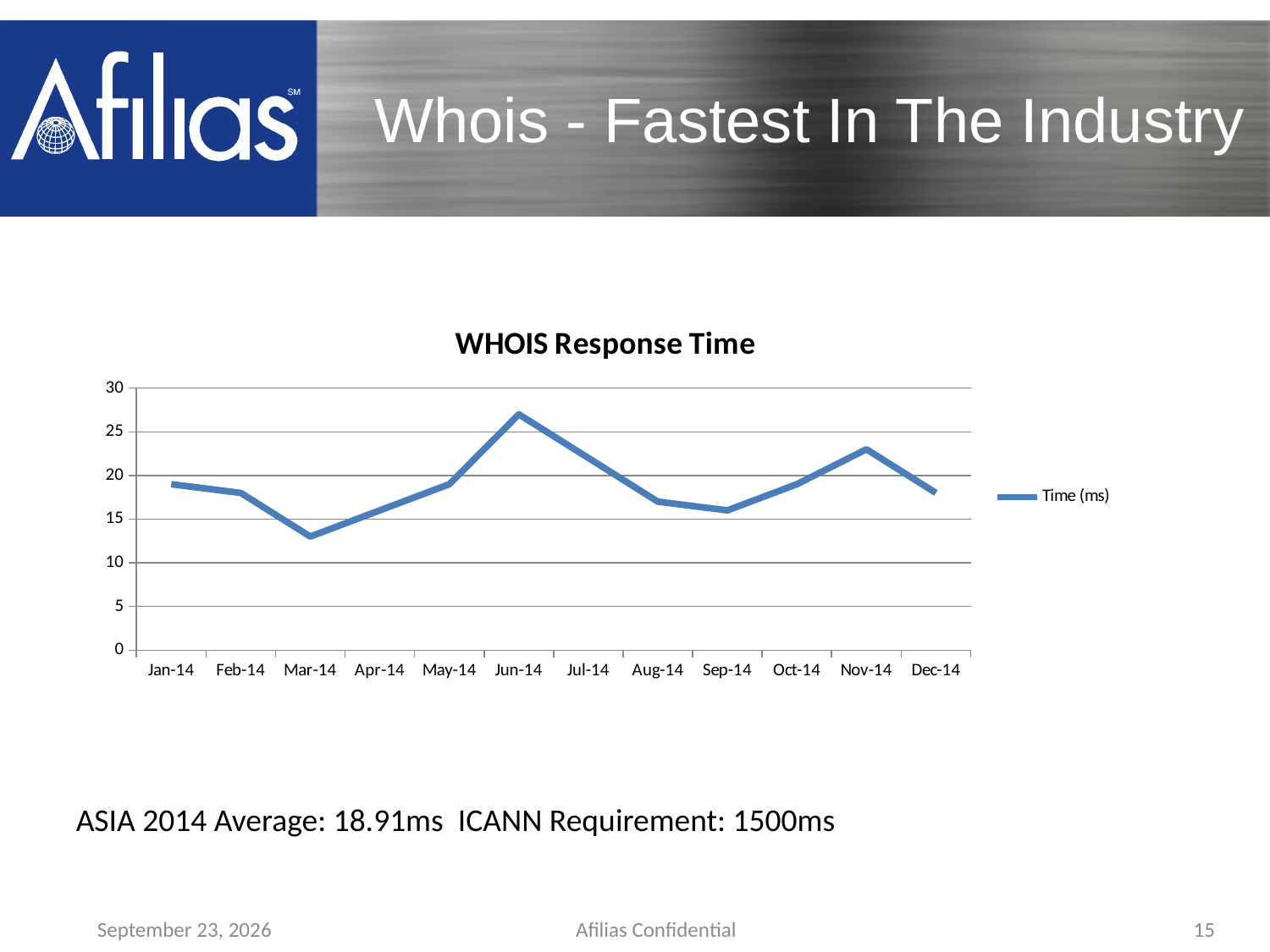
Which is larger, the value for Jun-14 or the value for Nov-14? Jun-14 What kind of chart is shown on the slide? Line chart Is the value for Nov-14 greater or less than 20? greater Is the value for Mar-14 greater or less than 15? less What is the title of the chart? WHOIS Response Time What is the legend entry for the plotted series? Time (ms) Does the response time rise or fall from Jun-14 to Sep-14? Fall Which month has the highest response time? Jun-14 Which month has the lowest response time? Mar-14 How many series does the legend list? 1 Is the value for Jun-14 greater or less than 25? greater How many months are plotted along the x axis? 12